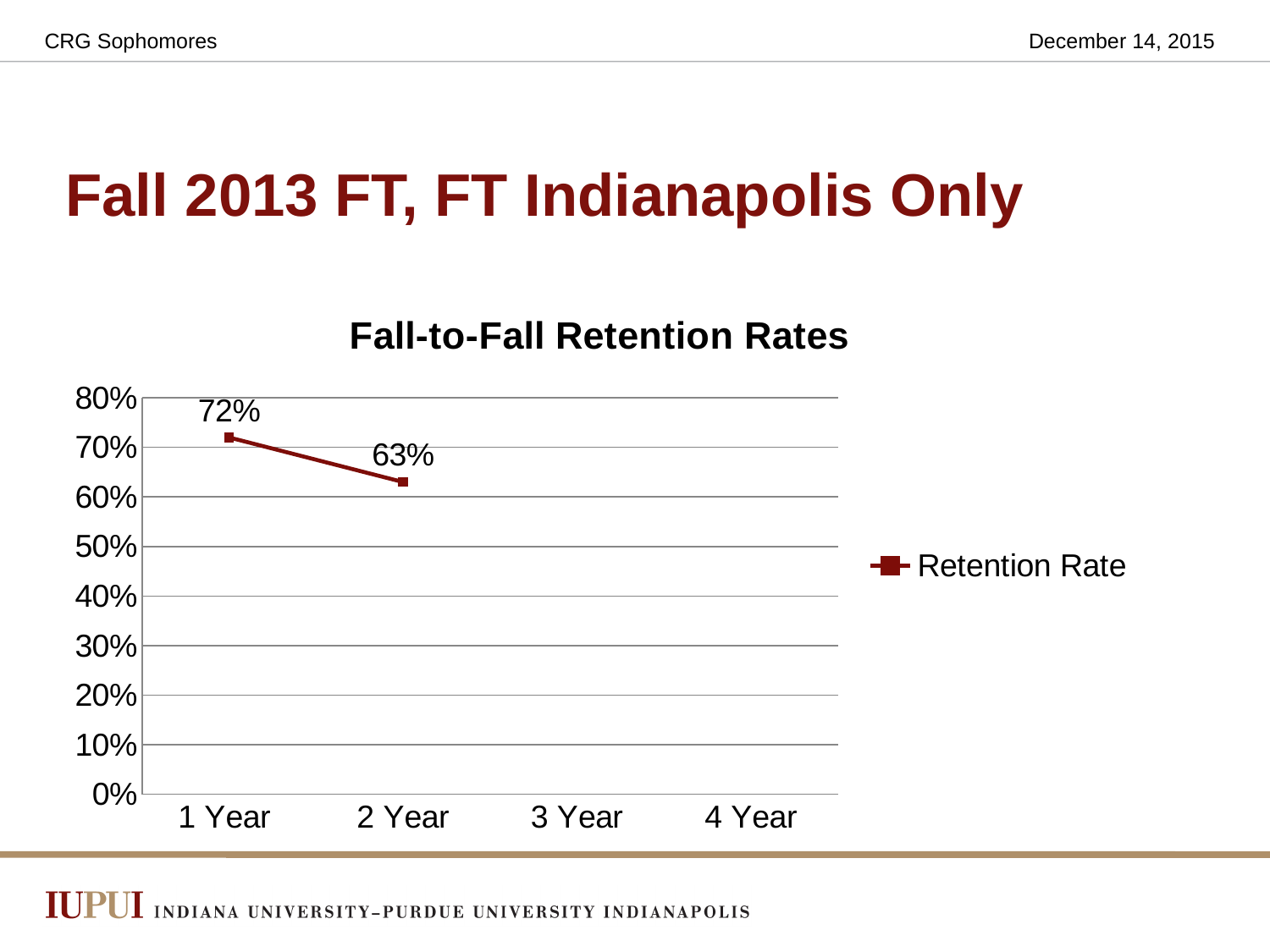
What is the retention rate at 1 Year? 72% What is the retention rate at 2 Year? 63% Which is larger, the retention rate at 1 Year or at 2 Year? 1 Year Is the retention rate at 1 Year greater or less than 70%? greater Does the retention rate rise or fall from 1 Year to 2 Year? fall How many categories are shown on the x axis? 4 Which category has the highest retention rate? 1 Year What kind of chart is shown? line chart Which of the plotted categories has the lowest retention rate? 2 Year How many data points are plotted on the chart? 2 Is the retention rate at 2 Year greater or less than 70%? less What is the difference between the 1 Year and 2 Year retention rates? 9%